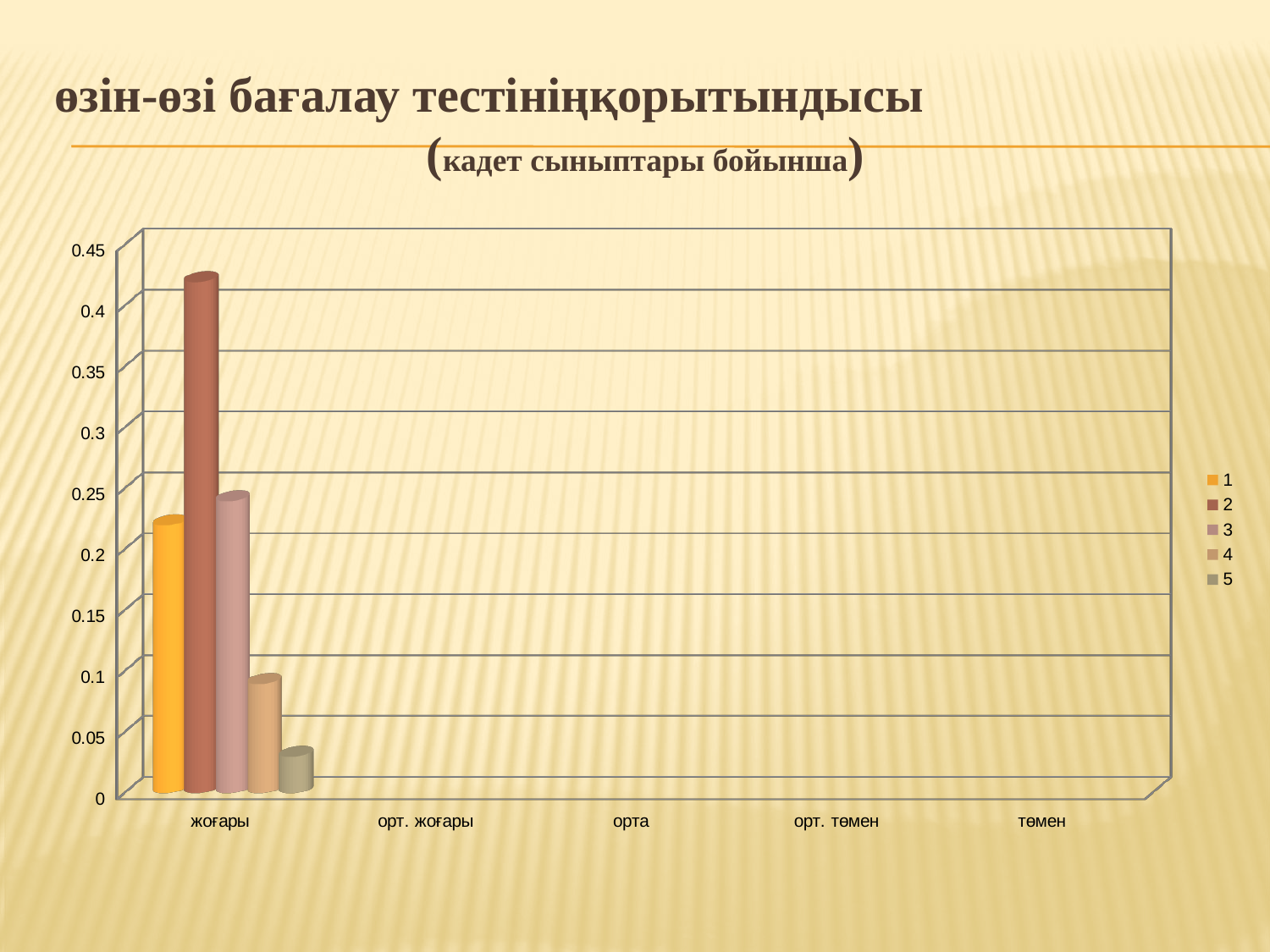
Which category on the x axis is the only one with bars plotted? жоғары What kind of chart is shown on the slide? bar chart Is the value for series 4 in the жоғары category greater or less than 0.1? less How many categories are shown on the x axis? 5 Is the value for series 5 in the жоғары category greater or less than 0.05? less In the жоғары category, which is larger: the value for series 2 or the value for series 4? series 2 Is the value for series 1 in the жоғары category greater or less than 0.2? greater How many series does the legend list? 5 Which series has the highest bar in the жоғары category? 2 Which series has the lowest bar in the жоғары category? 5 In the жоғары category, which is larger: the value for series 3 or the value for series 5? series 3